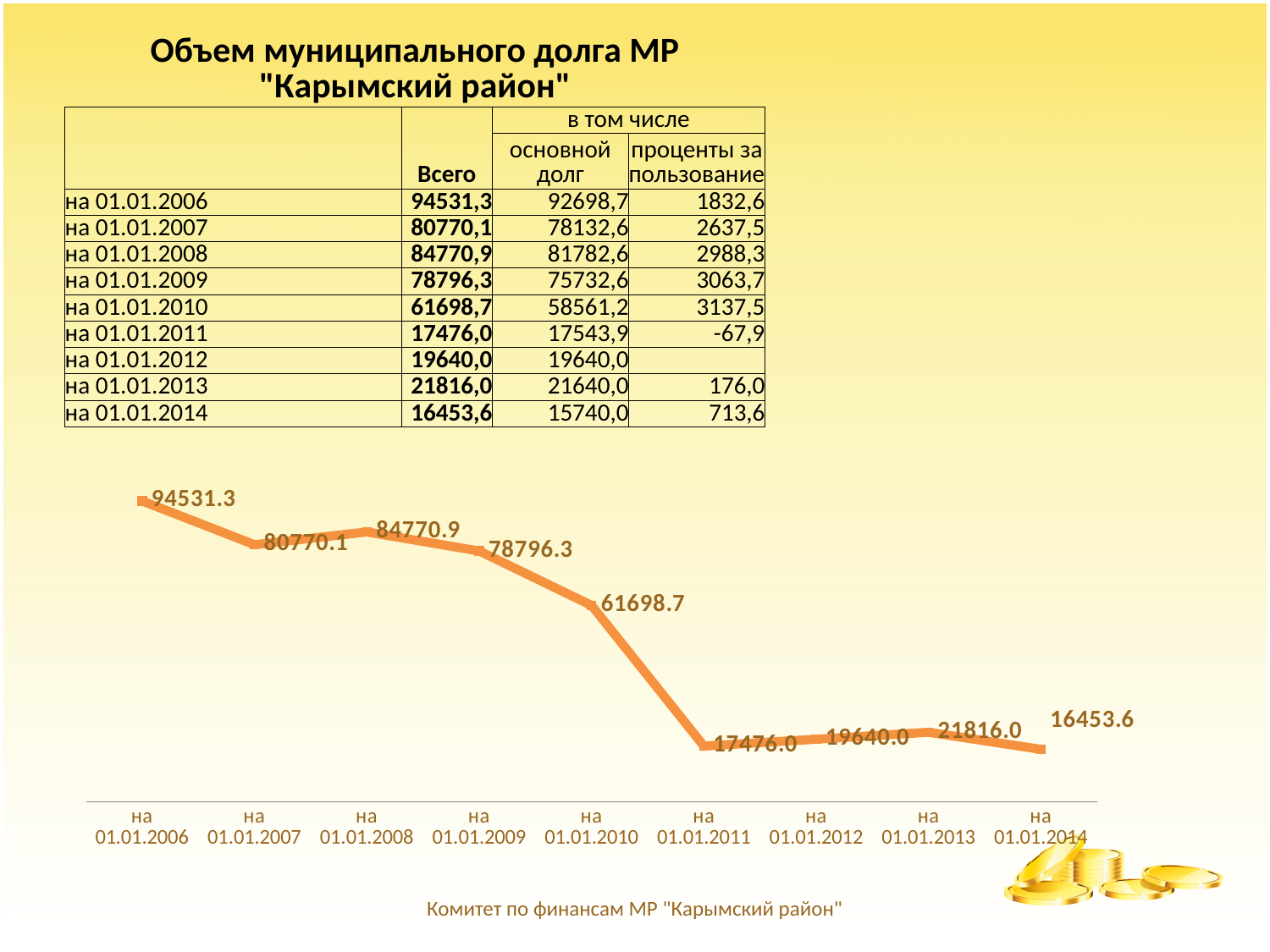
What is the value plotted for на 01.01.2006? 94531.3 What is the value plotted for на 01.01.2012? 19640.0 What is the value plotted for на 01.01.2010? 61698.7 What type of chart is shown on the slide? line chart Do the values generally rise or fall from на 01.01.2006 to на 01.01.2014? fall Which date has the highest value on the chart? на 01.01.2006 How many data points are plotted on the line chart? 9 What is the difference between the values for на 01.01.2006 and на 01.01.2007? 13761.2 Which is larger, the value for на 01.01.2008 or the value for на 01.01.2009? на 01.01.2008 What is the value plotted for на 01.01.2014? 16453.6 What is the difference between the values for на 01.01.2013 and на 01.01.2014? 5362.4 Which date has the lowest value on the chart? на 01.01.2014